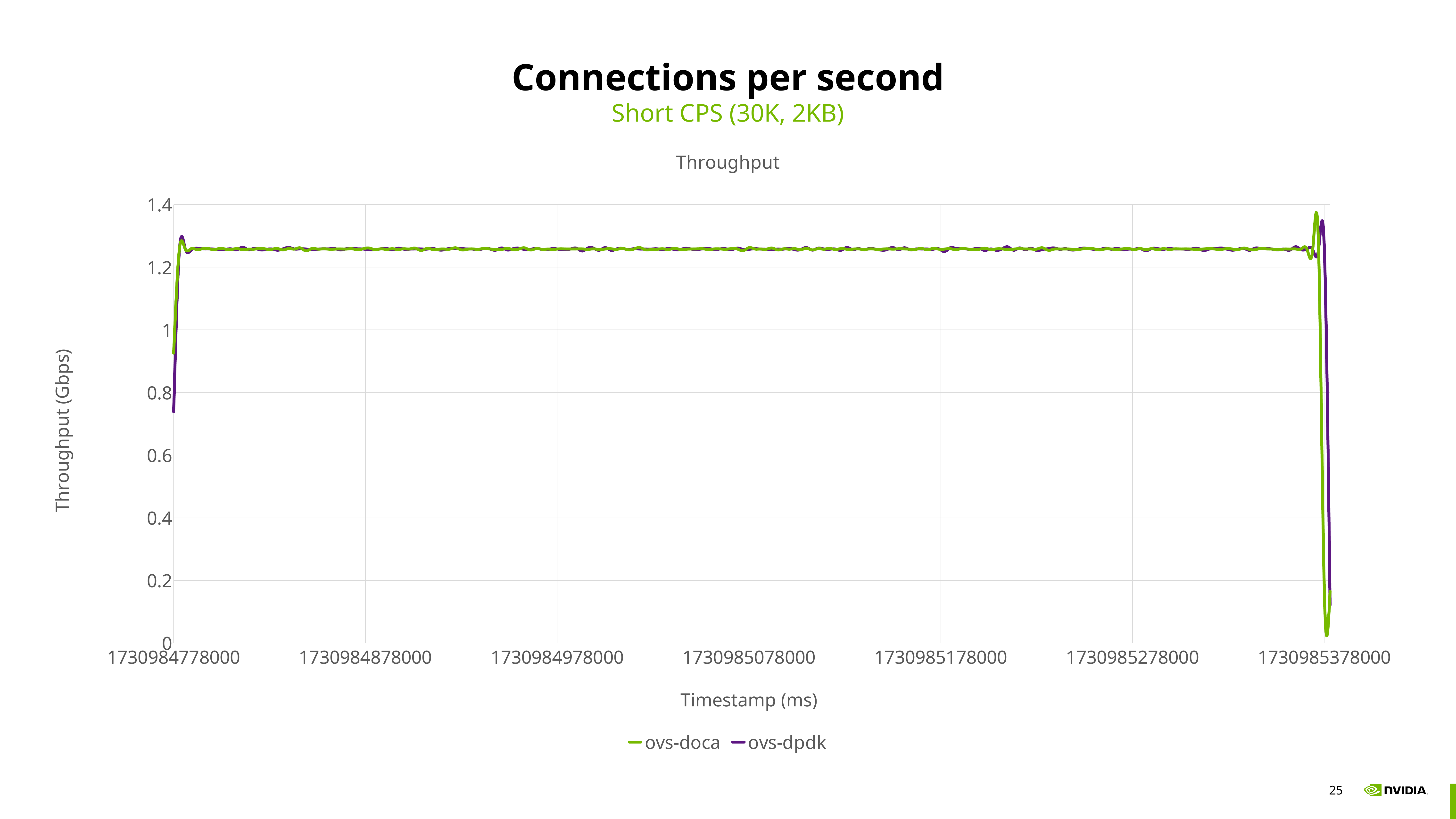
What is the title of the chart? Throughput Is the steady-state throughput for ovs-doca in the middle of the run greater or less than 1.2 Gbps? greater Is the throughput for ovs-dpdk at the first timestamp greater or less than 1 Gbps? less What kind of chart is shown on the slide? line chart Between the initial ramp-up and the final drop, does the throughput for ovs-doca rise, fall, or stay roughly flat along the x axis? stay roughly flat What are the names of the two series in the legend? ovs-doca and ovs-dpdk Is the steady-state throughput for ovs-dpdk in the middle of the run greater or less than 1.4 Gbps? less How many series does the legend list? 2